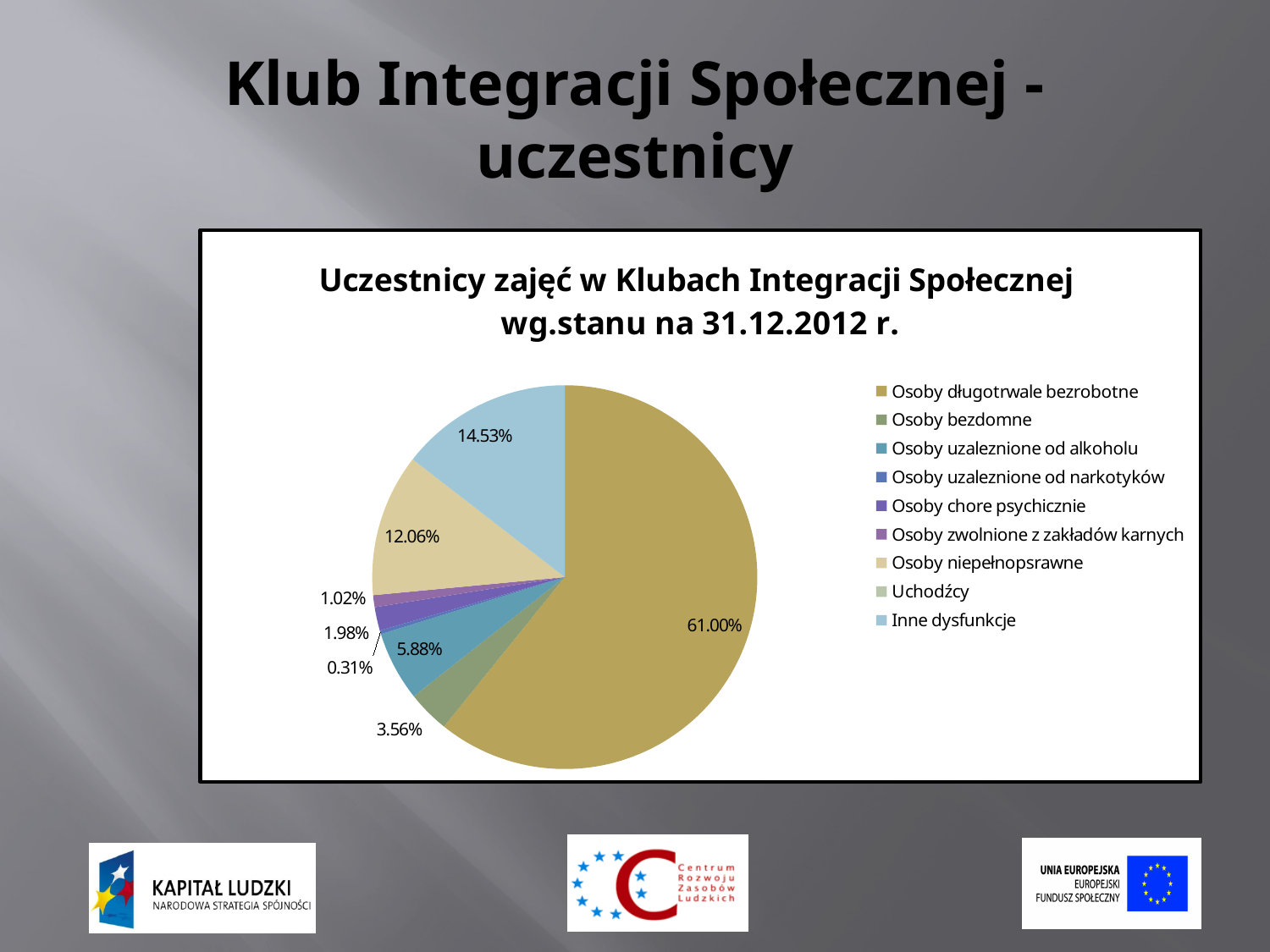
What share of the pie is 'Osoby bezdomne'? 3.56% What is the title of the chart? Uczestnicy zajęć w Klubach Integracji Społecznej wg.stanu na 31.12.2012 r. What share of the pie is 'Osoby długotrwale bezrobotne'? 61.00% What is the difference between the share for 'Osoby uzaleznione od alkoholu' and the share for 'Osoby bezdomne'? 2.32% Which category has the largest slice of the pie? Osoby długotrwale bezrobotne What share of the pie is 'Inne dysfunkcje'? 14.53% How many categories does the legend list? 9 What type of chart is shown on the slide? pie chart Which is larger: the slice for 'Inne dysfunkcje' or the slice for 'Osoby niepełnopsrawne'? Inne dysfunkcje What is the difference between the share for 'Osoby długotrwale bezrobotne' and the share for 'Inne dysfunkcje'? 46.47%